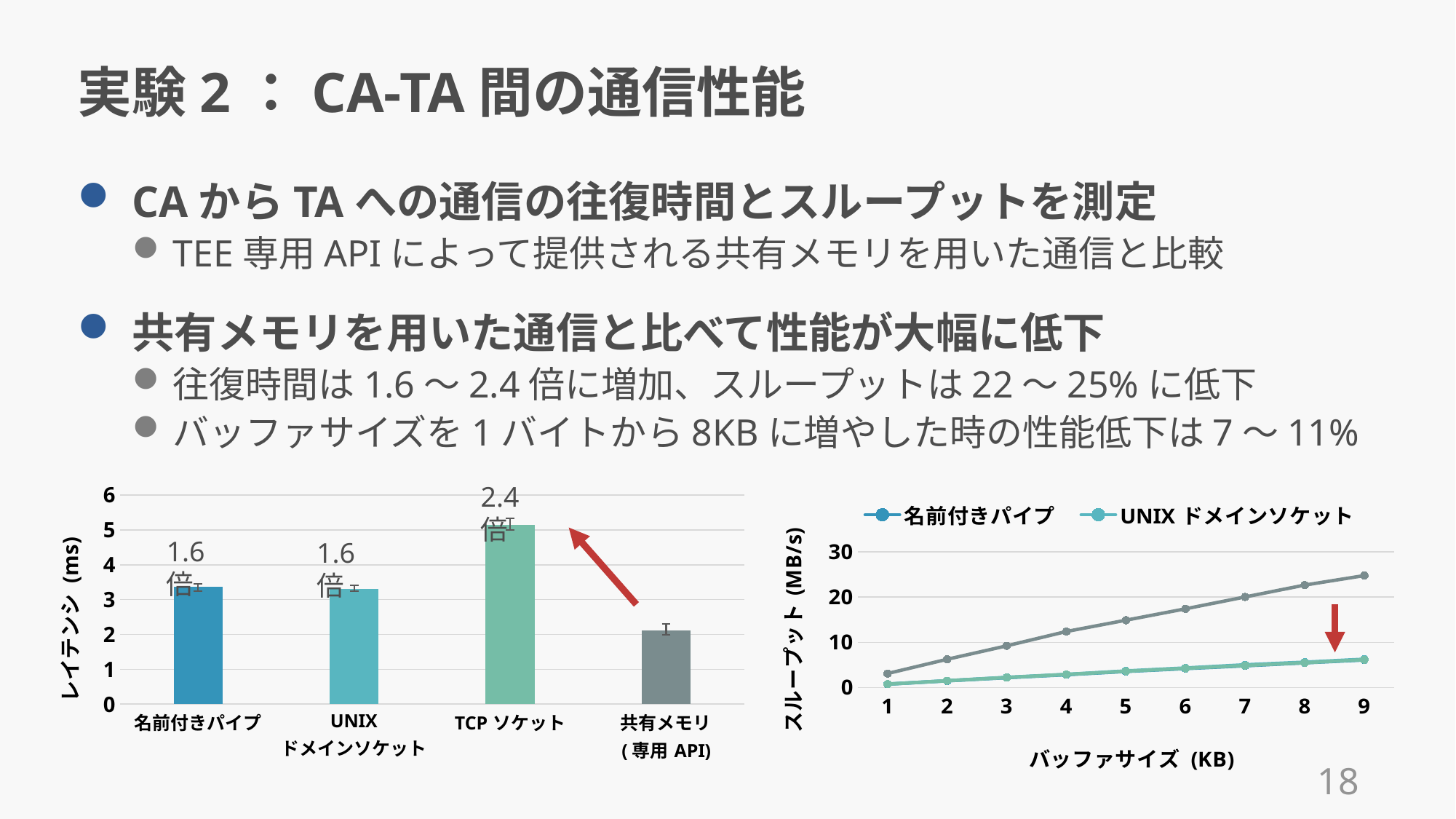
In the left chart (レイテンシ), which is larger, the value for TCP ソケット or the value for 名前付きパイプ? TCP ソケット In the left chart (レイテンシ), how many categories are shown on the x axis? 4 In the right chart (スループット), is the value for 名前付きパイプ at buffer size 9 greater or less than 20? less In the right chart (スループット), does the throughput of 名前付きパイプ rise or fall as buffer size increases? rise What kind of chart is the right chart (スループット)? line chart In the right chart (スループット), how many series does the legend list? 2 In the left chart (レイテンシ), which category has the highest latency? TCP ソケット In the left chart (レイテンシ), is the value for TCP ソケット greater or less than 5? greater What kind of chart is the left chart (レイテンシ)? bar chart In the left chart (レイテンシ), is the value for 共有メモリ ( 専用 API) greater or less than 3? less In the left chart (レイテンシ), which category has the lowest latency? 共有メモリ ( 専用 API)